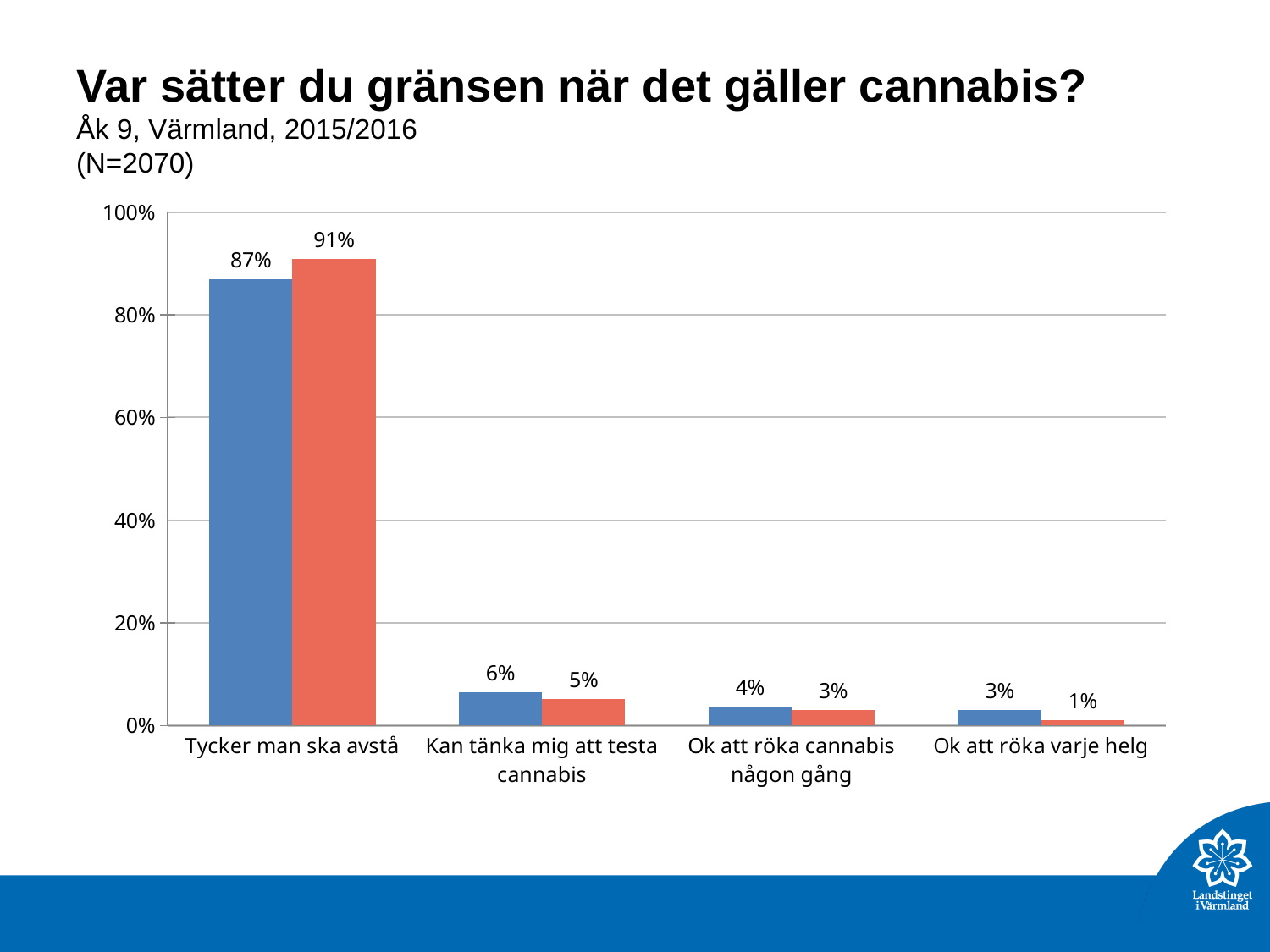
What is the value of the blue bar for "Kan tänka mig att testa cannabis"? 6% For "Tycker man ska avstå", which bar is larger, the blue or the orange one? orange What is the sample size (N) stated under the chart title? N=2070 What is the value of the blue bar for "Tycker man ska avstå"? 87% Which category has the highest values in the chart? Tycker man ska avstå How many categories are shown on the x axis? 4 What is the value of the orange bar for "Ok att röka varje helg"? 1% What kind of chart is shown on the slide? bar chart What is the value of the orange bar for "Tycker man ska avstå"? 91% Which category has the lowest orange bar? Ok att röka varje helg What is the difference between the blue and orange bars for "Ok att röka varje helg"? 2% What is the difference between the orange and blue bars for "Tycker man ska avstå"? 4%